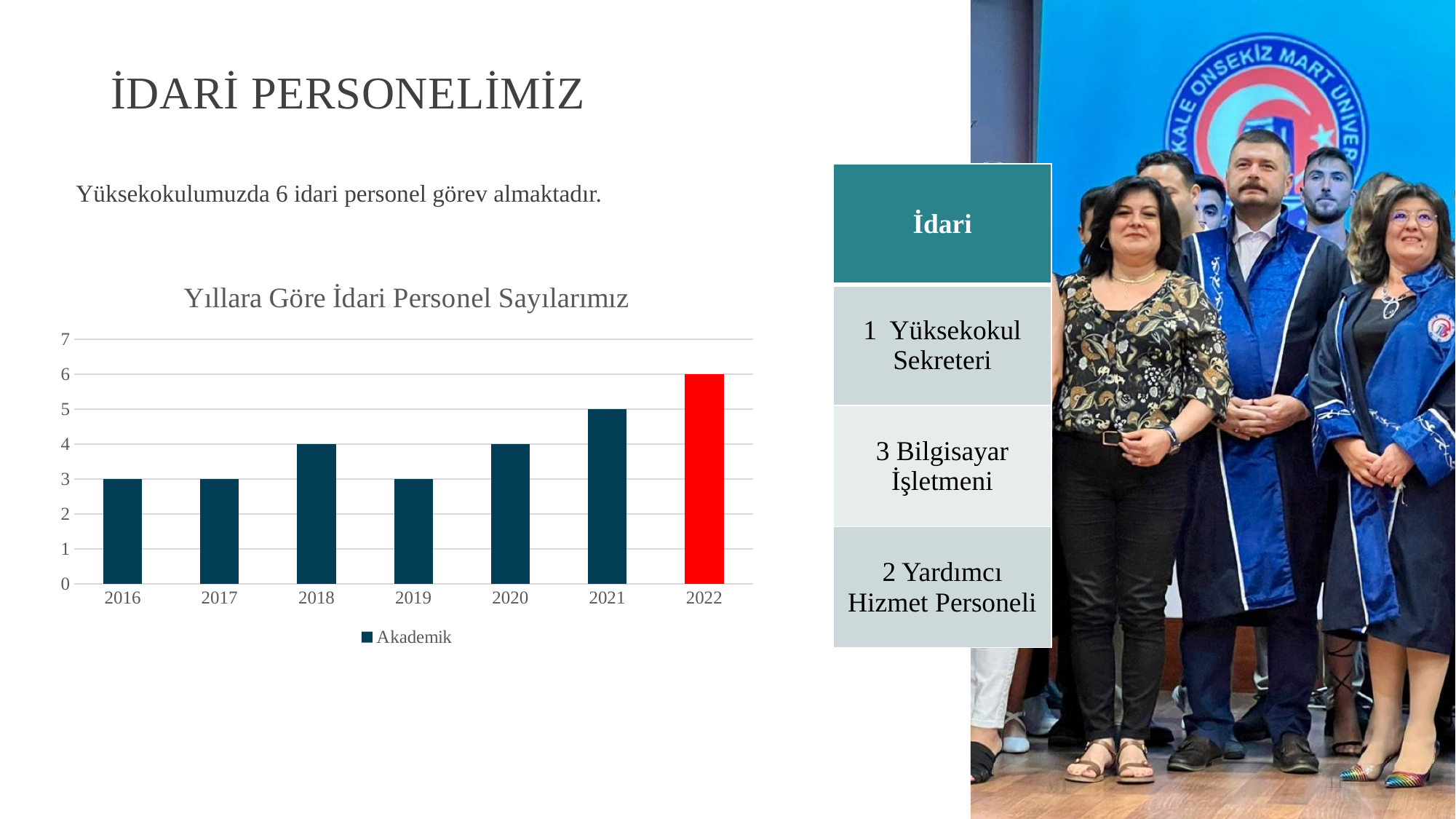
Which is larger, the value for 2018 or the value for 2019? 2018 Which year has the highest value in the chart? 2022 Is the value for 2021 greater or less than 4? greater What is the value for 2021 in the chart? 5 How many years are shown on the x axis of the chart? 7 How many series does the chart legend list? 1 What is the value for 2022 in the chart? 6 Which bar in the chart is coloured red? 2022 What is the difference between the values for 2022 and 2021? 1 What is the value for 2016 in the chart? 3 What is the title of the chart? Yıllara Göre İdari Personel Sayılarımız What type of chart is shown on the slide? bar chart